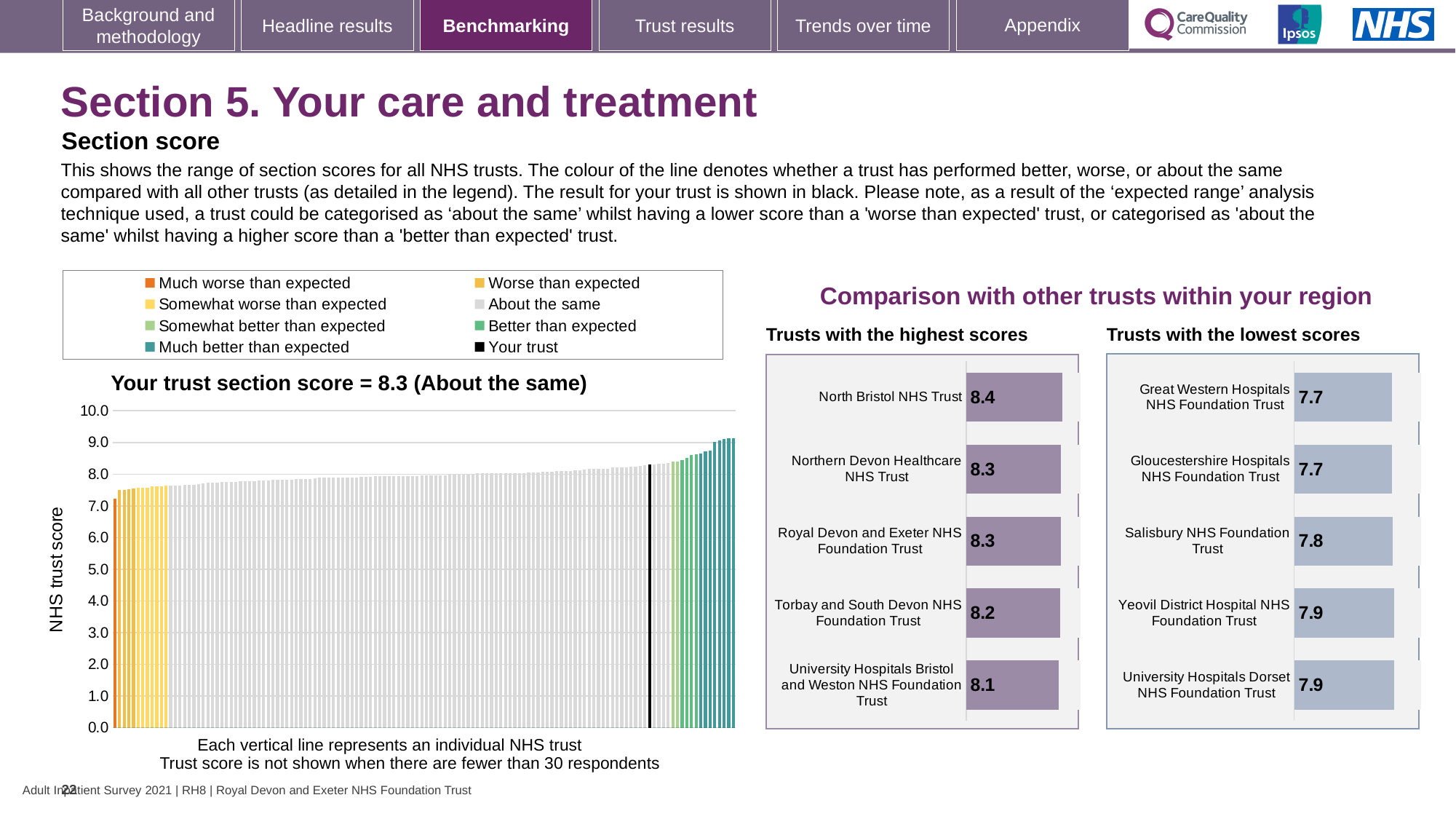
How many trusts are shown in the 'Trusts with the highest scores' chart? 5 In the 'Trusts with the lowest scores' chart, what is the difference between the scores of Salisbury NHS Foundation Trust and Great Western Hospitals NHS Foundation Trust? 0.1 In the 'Your trust section score' chart, do the bar values rise or fall from left to right? rise In the 'Trusts with the highest scores' chart, what is the score for North Bristol NHS Trust? 8.4 In the 'Trusts with the highest scores' chart, which trust has the lowest score? University Hospitals Bristol and Weston NHS Foundation Trust In the 'Trusts with the highest scores' chart, what is the difference between the scores of North Bristol NHS Trust and University Hospitals Bristol and Weston NHS Foundation Trust? 0.3 What is the y-axis label of the 'Your trust section score' chart? NHS trust score How many entries does the legend above the 'Your trust section score' chart list? 8 In the 'Trusts with the lowest scores' chart, which has the larger score: Salisbury NHS Foundation Trust or Yeovil District Hospital NHS Foundation Trust? Yeovil District Hospital NHS Foundation Trust In the 'Your trust section score' chart, what is the section score for your trust? 8.3 What kind of chart is the 'Your trust section score' chart? bar chart In the 'Trusts with the lowest scores' chart, what is the score for Salisbury NHS Foundation Trust? 7.8